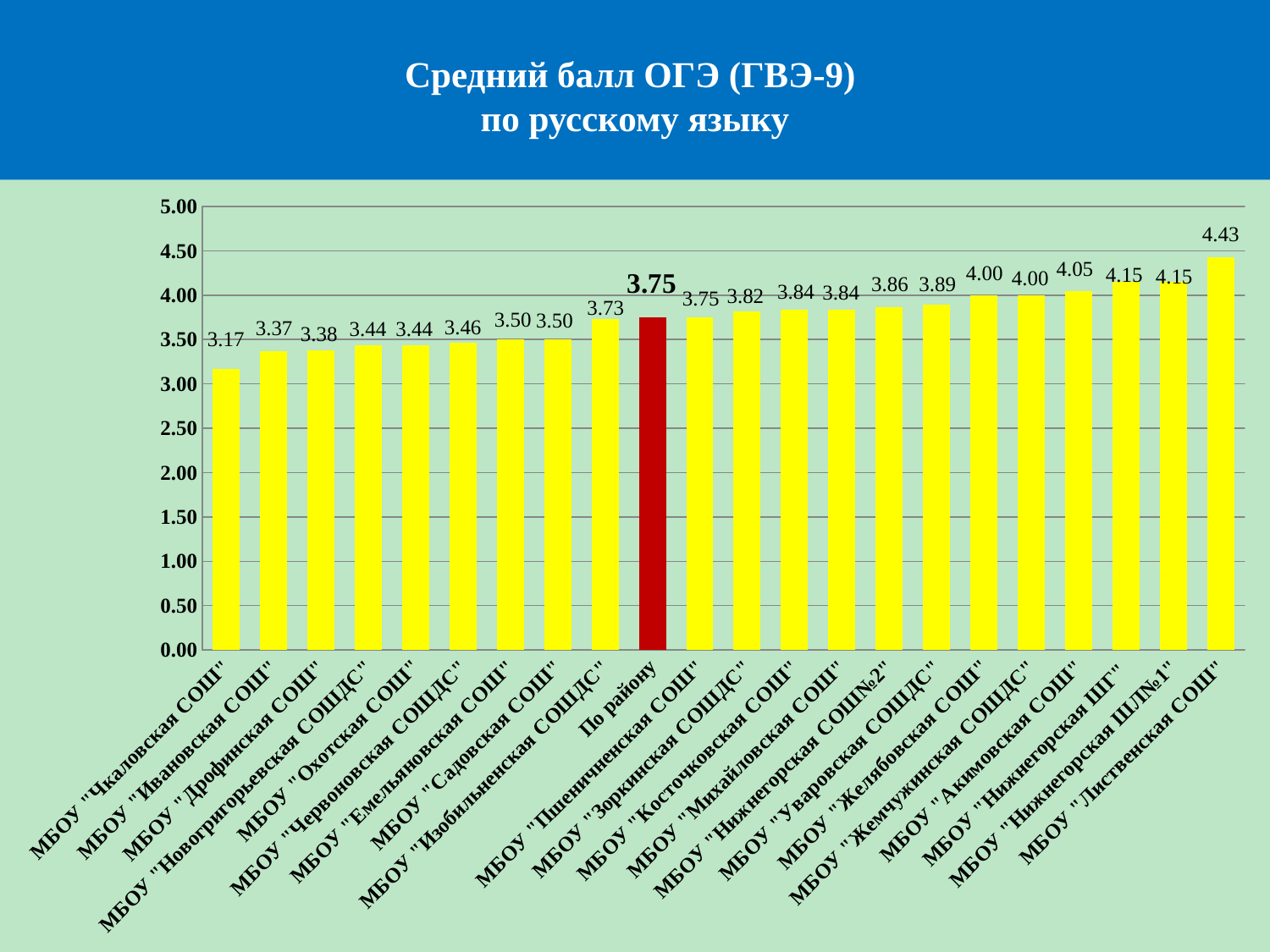
How many bars are plotted in the chart? 22 What is the difference between the scores of МБОУ "Лиственская СОШ" and МБОУ "Чкаловская СОШ"? 1.26 Which bar is coloured red instead of yellow? По району Do the values generally rise or fall from left to right along the x axis? rise What is the average score for МБОУ "Чкаловская СОШ"? 3.17 Which school has the lowest average score? МБОУ "Чкаловская СОШ" Which school has the highest average score? МБОУ "Лиственская СОШ" What type of chart is shown on the slide? bar chart What is the value shown for "По району"? 3.75 What is the average score for МБОУ "Уваровская СОШДС"? 3.89 Which has a higher average score: МБОУ "Акимовская СОШ" or МБОУ "Зоркинская СОШДС"? МБОУ "Акимовская СОШ" Is the value for МБОУ "Изобильненская СОШДС" greater or less than 4.00? less